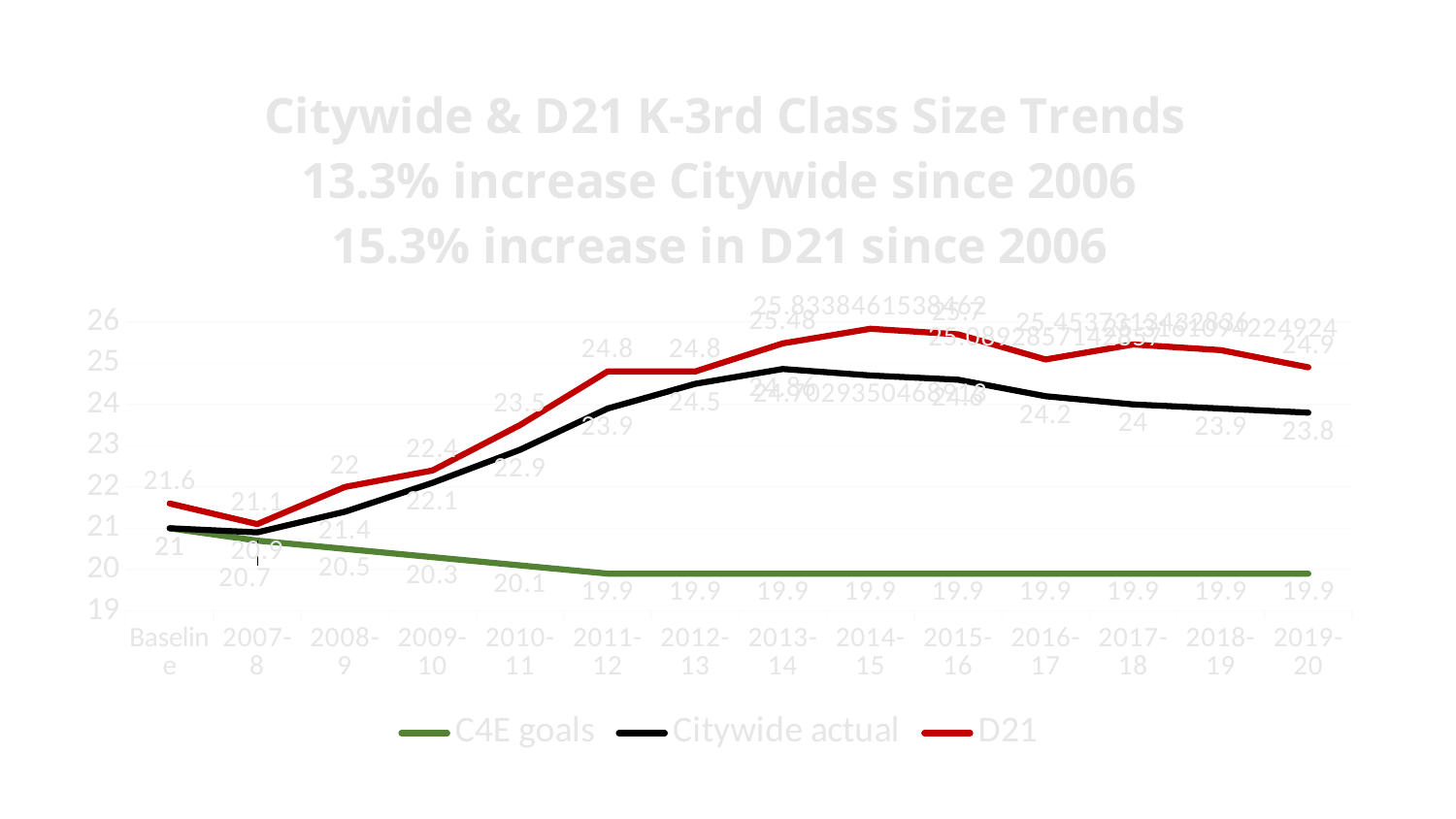
What is the C4E goals value for 2011-12? 19.9 What is the D21 value for 2019-20? 24.9 How many categories are shown along the x axis? 14 How many series does the legend list? 3 Do the C4E goals values rise or fall from Baseline to 2011-12? fall Which series is shown in red in the legend? D21 Is the D21 value for 2014-15 greater or less than 25? greater What is the D21 value for 2013-14? 25.48 In 2010-11, which is larger: the D21 value or the Citywide actual value? D21 What kind of chart is shown on the slide? line chart What is the difference between the D21 and Citywide actual values in 2019-20? 1.1 What is the Citywide actual value for 2019-20? 23.8